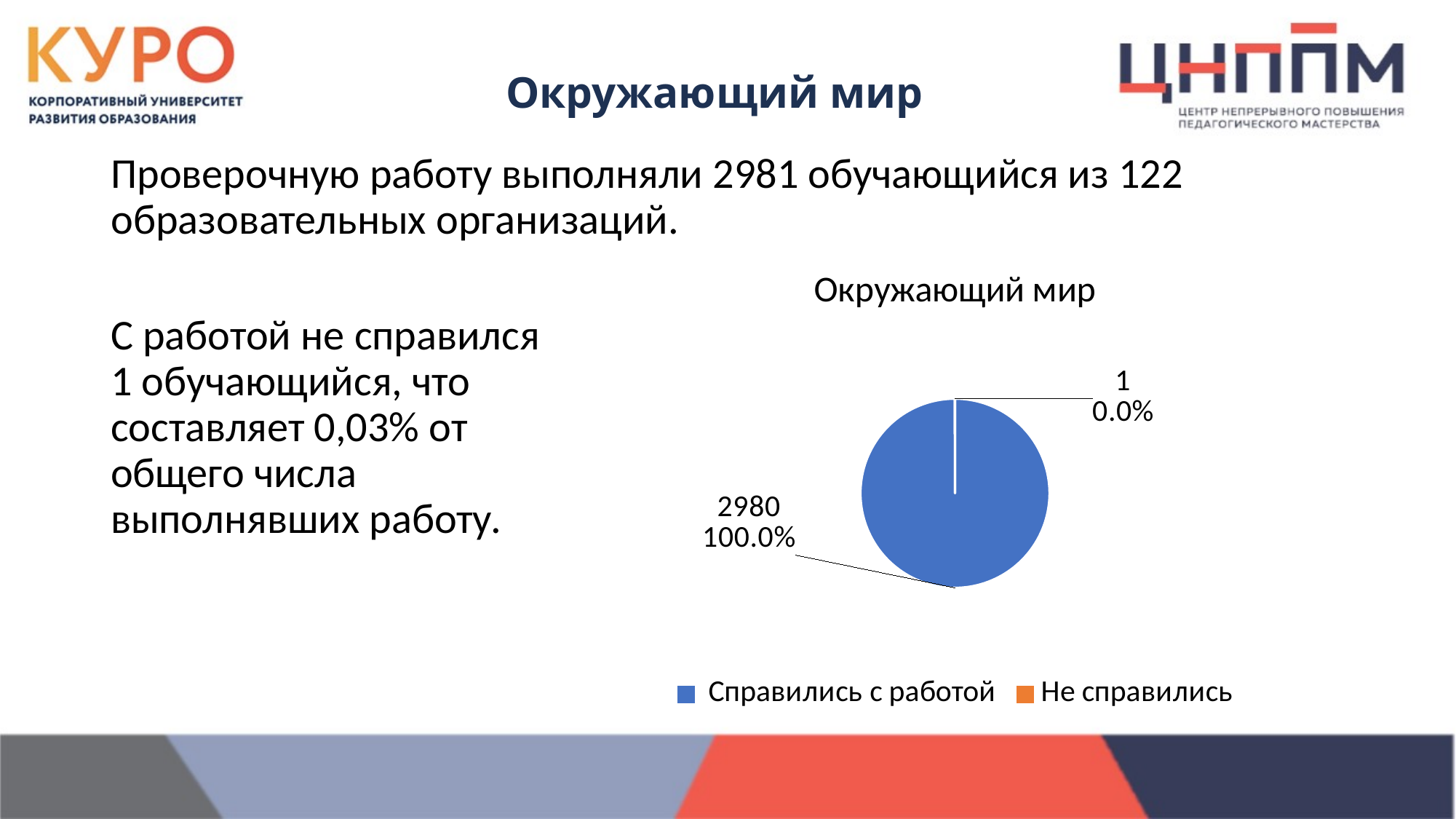
What is the value for "Справились с работой"? 2980 How many entries does the chart legend list? 2 What percentage share is shown for "Не справились"? 0.0% Which is larger: the value for "Справились с работой" or for "Не справились"? Справились с работой What percentage share is shown for "Справились с работой"? 100.0% Which category has the smallest slice of the pie? Не справились What is the value for "Не справились"? 1 What is the difference between the values for "Справились с работой" and "Не справились"? 2979 What kind of chart is shown on the slide? pie chart Which category has the largest slice of the pie? Справились с работой What colour is the slice for "Справились с работой"? blue What is the title of the chart? Окружающий мир